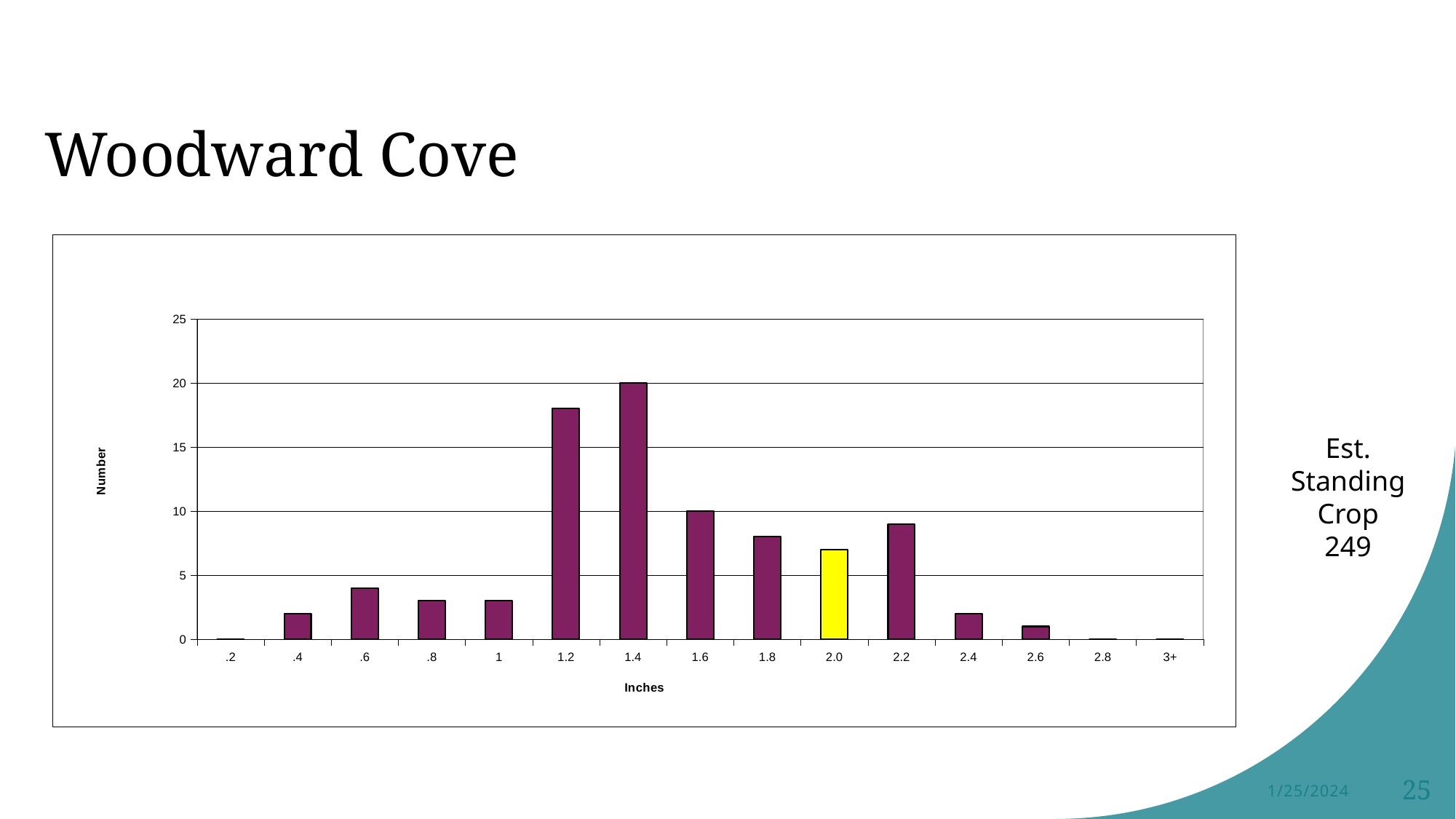
Which inches category has the highest bar? 1.4 Is the value for 1.8 inches greater or less than 5? greater Is the value for 1.2 inches greater or less than 15? greater Which is larger, the value for .4 inches or the value for .6 inches? .6 What is the label on the x axis of the chart? Inches Is the value for .6 inches greater or less than 5? less What is the value for the 1.4 inches category? 20 Which bar is coloured yellow instead of purple? 2.0 How many inches categories are shown on the x axis? 15 What is the value for the 1.6 inches category? 10 What kind of chart is shown on the slide? bar chart